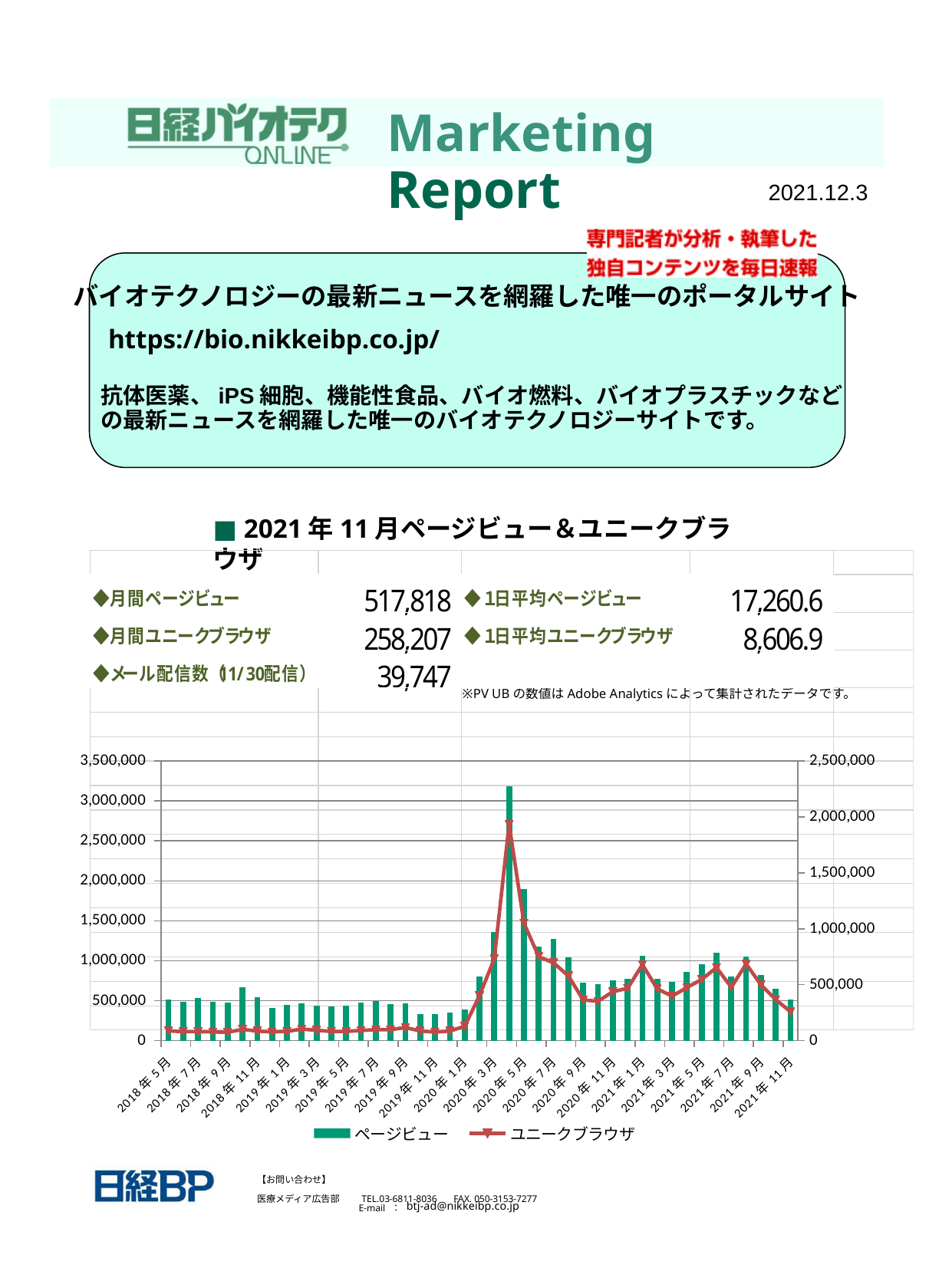
Do the ページビュー values rise or fall from 2021年7月 to 2021年11月? fall What kind of chart is shown on the slide? Combined bar and line chart Is the ページビュー value for 2021年7月 greater or less than 500,000? greater Is the ユニークブラウザ value for 2019年5月 greater or less than 500,000 on the right axis? less Which series is drawn as a line with markers in the chart? ユニークブラウザ Is the peak ページビュー value greater or less than 3,000,000? greater Which has the higher ページビュー value, 2020年5月 or 2020年7月? 2020年5月 In which year does the tallest ページビュー bar occur? 2020 Which series is drawn as bars in the chart? ページビュー How many series does the chart legend list? 2